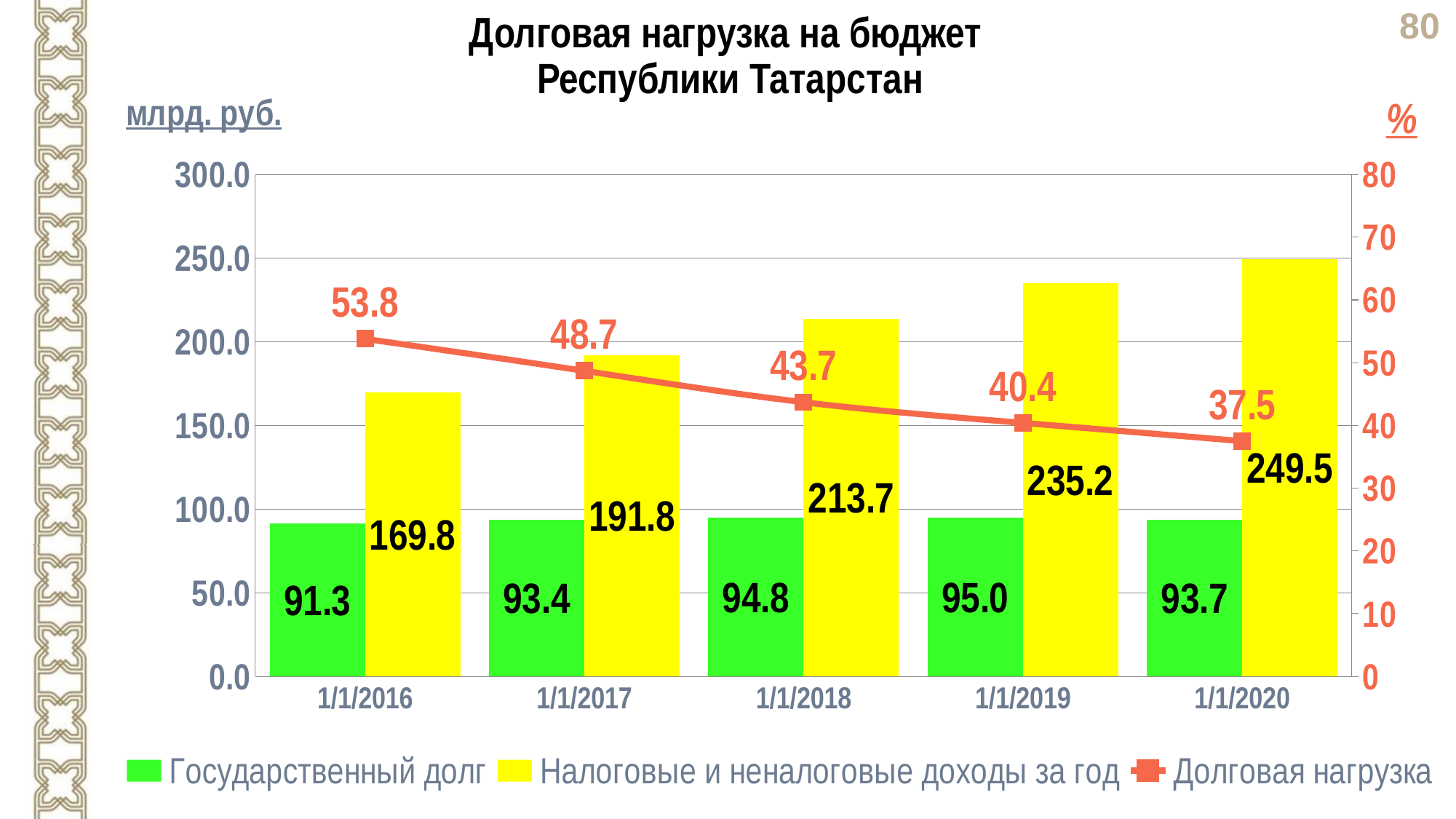
What is the value of Налоговые и неналоговые доходы за год on 1/1/2020? 249.5 What is the value of Государственный долг on 1/1/2018? 94.8 In which year is Долговая нагрузка the lowest? 1/1/2020 What is the title of the chart? Долговая нагрузка на бюджет Республики Татарстан How many dates are shown on the x axis? 5 In which year is Налоговые и неналоговые доходы за год the highest? 1/1/2020 What is the Долговая нагрузка value on 1/1/2016? 53.8 Which is larger: Государственный долг on 1/1/2016 or on 1/1/2019? 1/1/2019 How many series does the legend list? 3 What is the difference between Налоговые и неналоговые доходы за год on 1/1/2019 and on 1/1/2018? 21.5 Does Долговая нагрузка rise or fall from 1/1/2016 to 1/1/2020? fall Is the value of Налоговые и неналоговые доходы за год on 1/1/2017 greater or less than 200.0? less